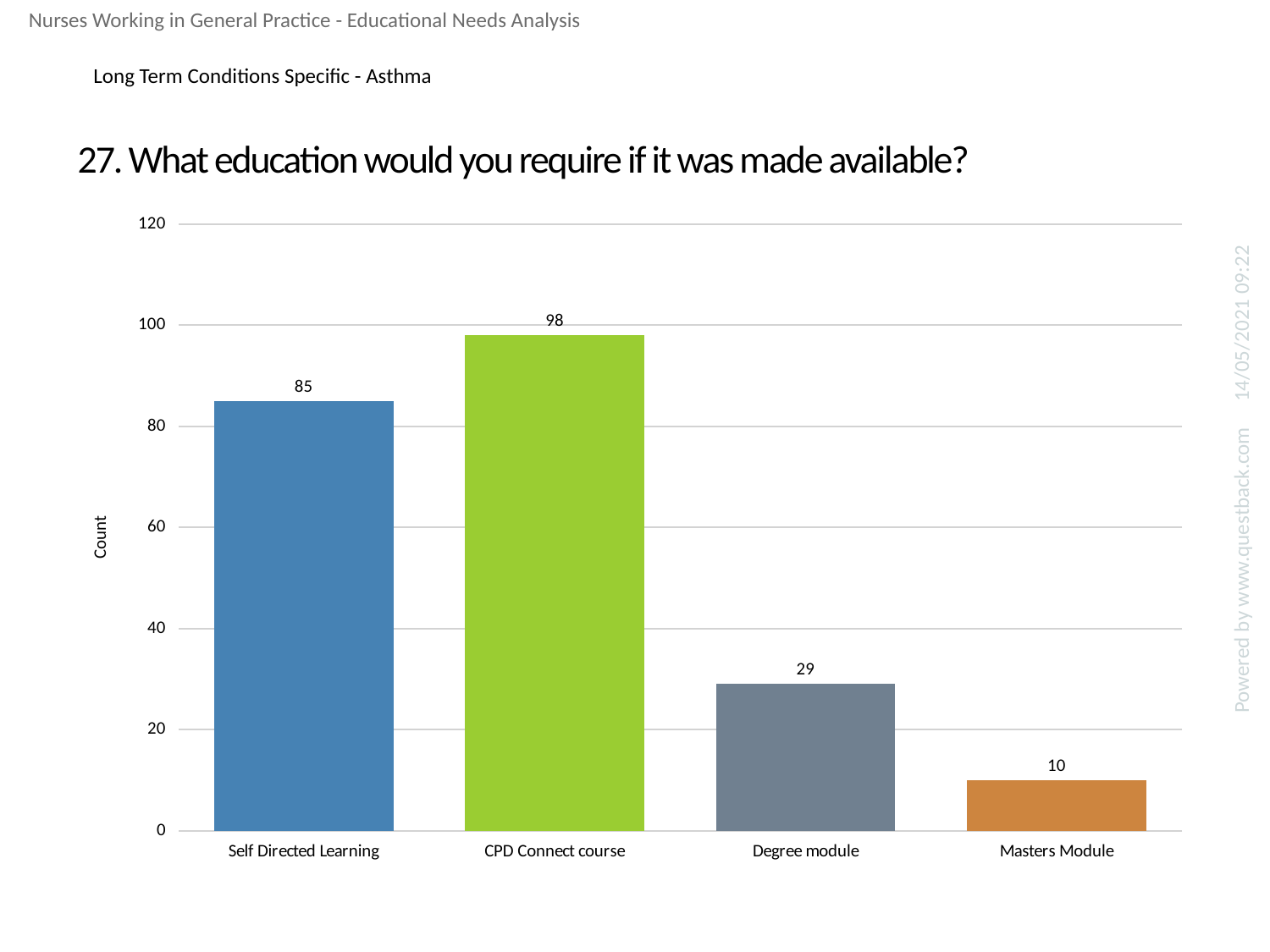
How many categories are shown on the x axis? 4 Which category has the highest count? CPD Connect course Which has a larger count, Self Directed Learning or Degree module? Self Directed Learning What is the count for Masters Module? 10 What is the difference between the counts for Degree module and Masters Module? 19 Which category has the lowest count? Masters Module What kind of chart is shown on the slide? Bar chart What is the count for CPD Connect course? 98 What is the count for Degree module? 29 What is the count for Self Directed Learning? 85 What is the difference between the counts for CPD Connect course and Self Directed Learning? 13 Is the value for Degree module greater or less than 40? less